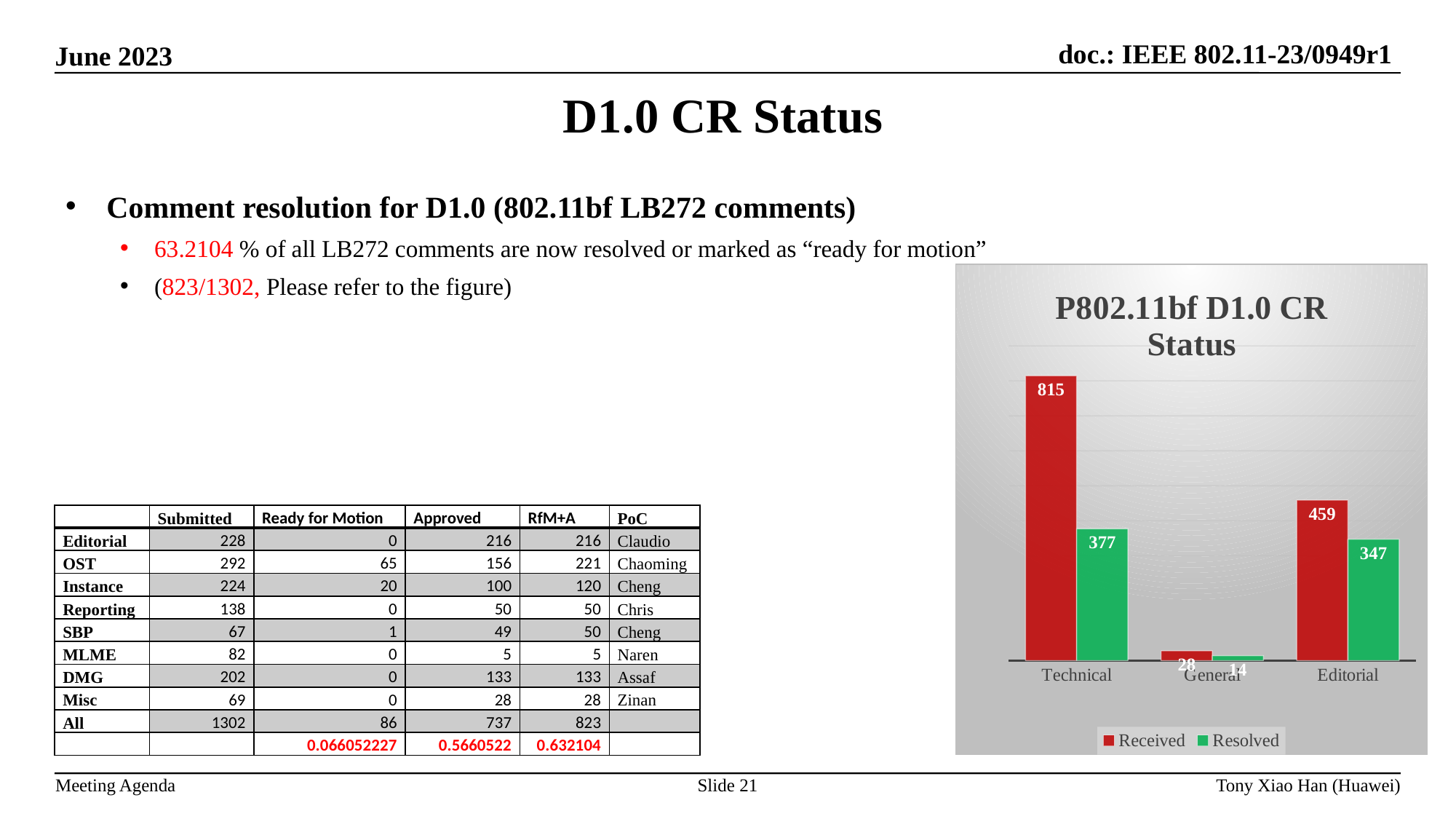
How many categories are shown on the x axis of the P802.11bf D1.0 CR Status chart? 3 In the P802.11bf D1.0 CR Status chart, which is larger: the Resolved value for Technical or the Received value for Editorial? Received value for Editorial What is the difference between the Received and Resolved values for Editorial in the P802.11bf D1.0 CR Status chart? 112 What type of chart is the P802.11bf D1.0 CR Status chart? Bar chart What is the Resolved value for Editorial in the P802.11bf D1.0 CR Status chart? 347 What is the Resolved value for Technical in the P802.11bf D1.0 CR Status chart? 377 How many series does the legend of the P802.11bf D1.0 CR Status chart list? 2 What is the difference between the Received and Resolved values for Technical in the P802.11bf D1.0 CR Status chart? 438 What is the Received value for General in the P802.11bf D1.0 CR Status chart? 28 Which category has the lowest Resolved value in the P802.11bf D1.0 CR Status chart? General Which category has the highest Received value in the P802.11bf D1.0 CR Status chart? Technical What is the Received value for Technical in the P802.11bf D1.0 CR Status chart? 815